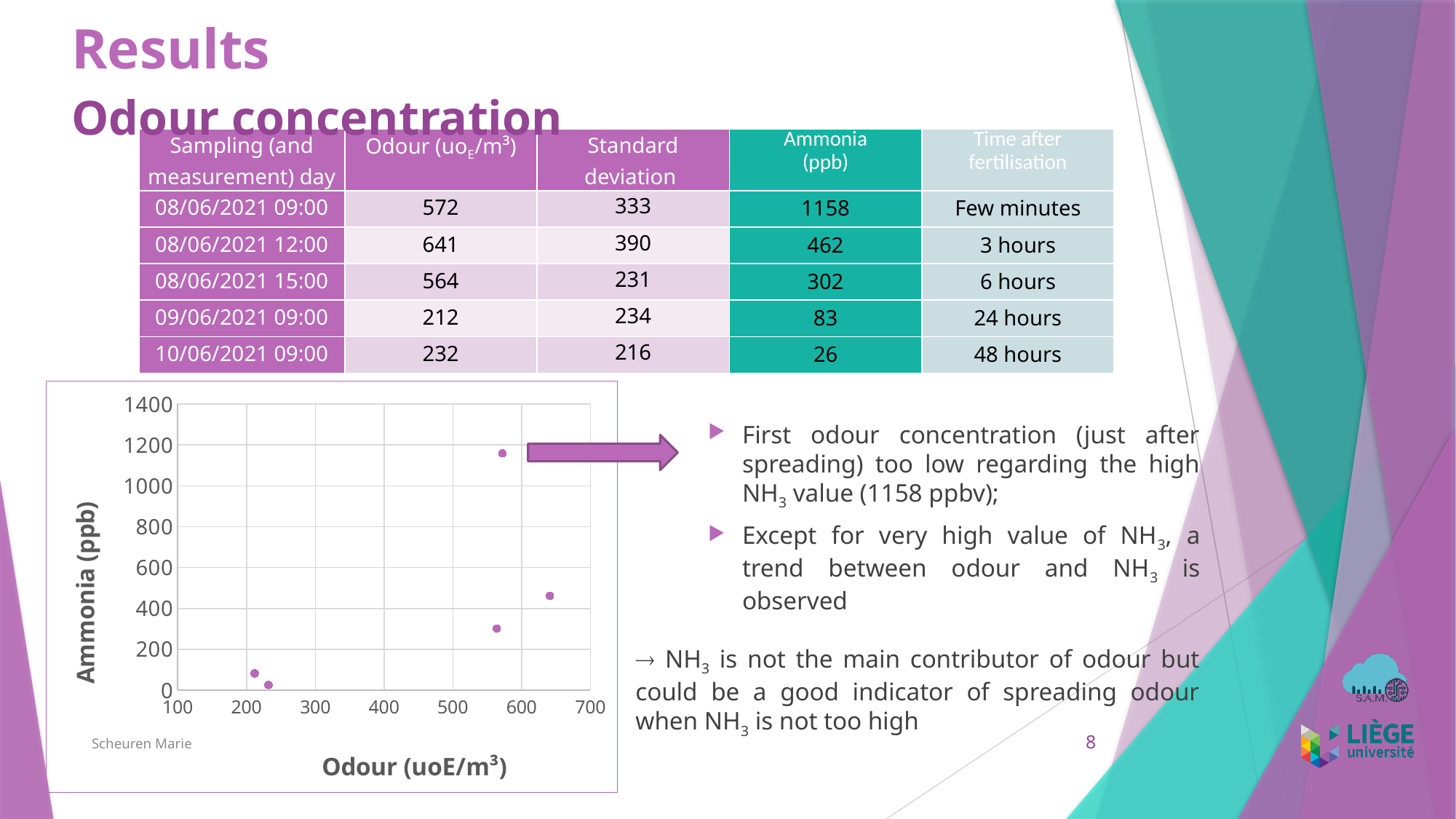
How many points in the scatter chart have an ammonia value above 1000? 1 Is the ammonia value of the point at an odour of about 640 greater or less than 600? less How many points in the scatter chart have an odour value below 300? 2 Do the ammonia values in the scatter chart generally rise or fall as odour increases? rise What kind of chart is shown on the slide? scatter chart How many data points are plotted in the scatter chart? 5 What is the title of the x axis of the scatter chart? Odour (uoE/m³) Is the ammonia value of the point at an odour of about 640 greater or less than 400? greater Is the ammonia value of the highest point in the scatter chart greater or less than 1000? greater What is the title of the y axis of the scatter chart? Ammonia (ppb)